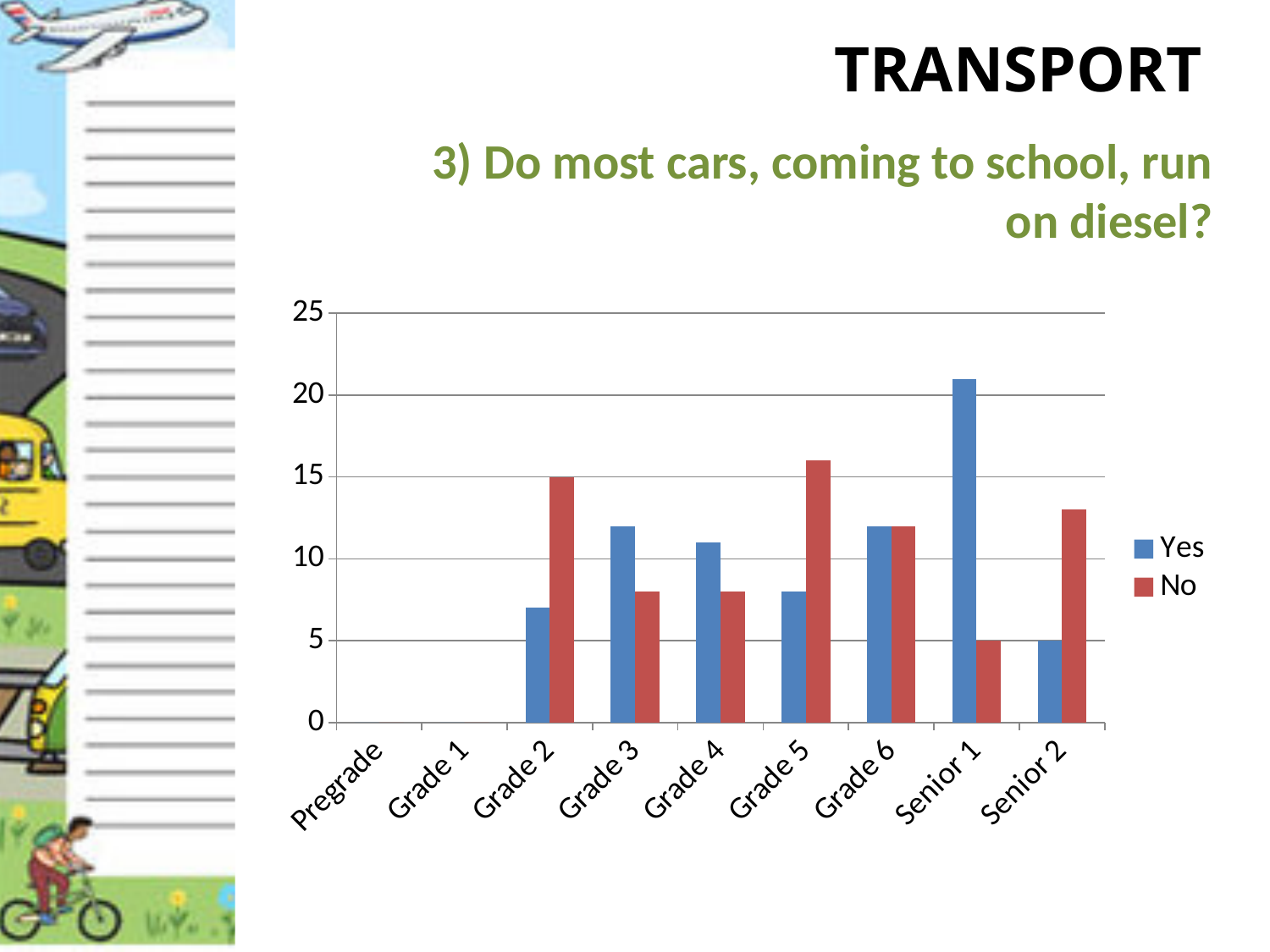
What kind of chart is shown on the slide? bar chart Is the Yes value for Grade 2 greater or less than 10? less Which colour represents the Yes series in the chart? blue For Senior 1, which is larger, the Yes value or the No value? Yes For Grade 2, which is larger, the Yes value or the No value? No Is the No value for Grade 5 greater or less than 15? greater How many series does the legend list? 2 Is the No value for Senior 2 greater or less than 10? greater Which category has the highest Yes value? Senior 1 How many grade categories are shown on the x axis? 9